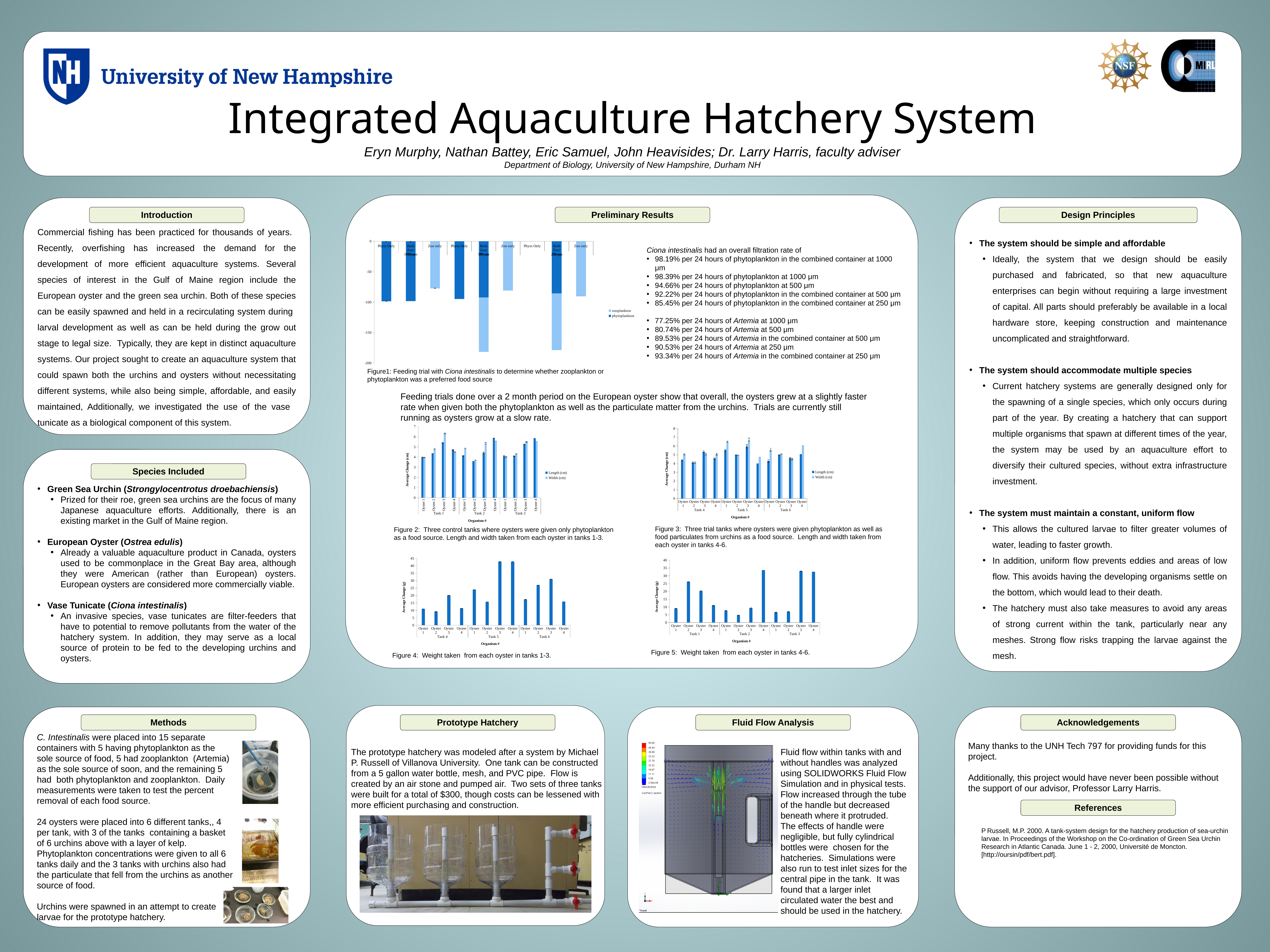
In Figure 2 (three control tanks), how many series does the legend list? 2 In Figure 4 (weight chart on the left), is the value for Oyster 3 in Tank 5 greater or less than 40? greater In Figure 5 (weight chart on the right), which is larger, the value for Oyster 2 in Tank 1 or the value for Oyster 1 in Tank 1? Oyster 2 in Tank 1 In Figure 4 (weight chart on the left), which oyster has the lowest weight change? Oyster 2 in Tank 4 In Figure 3 (three trial tanks, tanks 4-6), what are the two series named in the legend? Length (cm) and Width (cm) In Figure 5 (weight chart on the right), is the value for Oyster 4 in Tank 2 greater or less than 30? greater In Figure 1 (feeding trial with Ciona intestinalis), what are the two series named in the legend? zooplankton and phytoplankton What kind of chart is Figure 2 (three control tanks, oysters given only phytoplankton)? bar chart In Figure 1 (feeding trial with Ciona intestinalis), how many series does the legend list? 2 In Figure 3 (three trial tanks, tanks 4-6), how many oysters are plotted in total across the three tanks? 12 In Figure 5 (weight chart on the right), which oyster has the lowest weight change? Oyster 2 in Tank 2